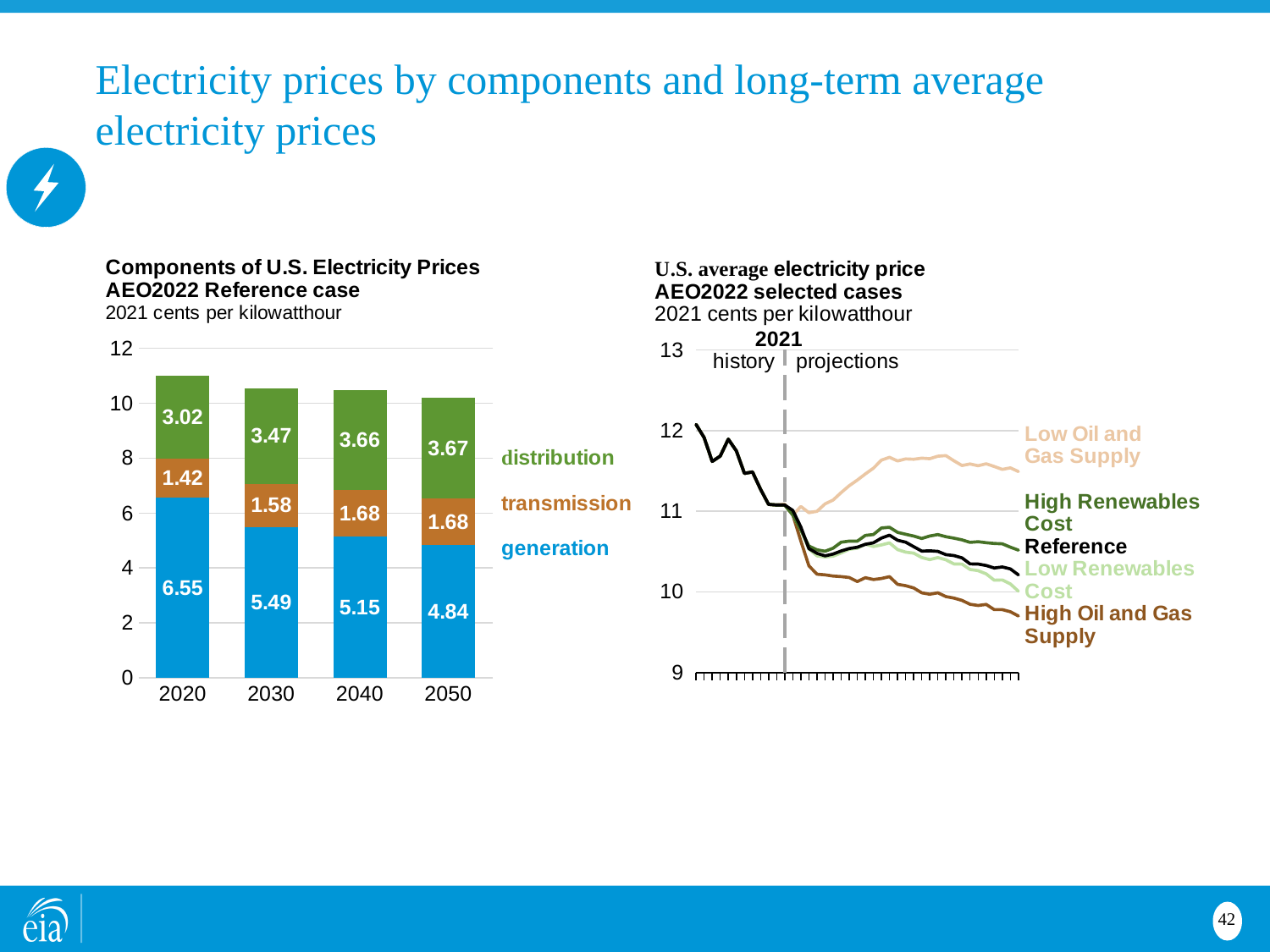
In the Components of U.S. Electricity Prices chart, what is the difference between the generation values for 2020 and 2050? 1.71 In the Components of U.S. Electricity Prices chart, which year has the highest generation value? 2020 In the Components of U.S. Electricity Prices chart, which year has the lowest distribution value? 2020 In the Components of U.S. Electricity Prices chart, does the generation component rise or fall from 2020 to 2050? fall In the U.S. average electricity price chart, is the value for the High Oil and Gas Supply case at the end of the projection greater or less than 10? less What kind of chart is the U.S. average electricity price chart on the right? line chart In the Components of U.S. Electricity Prices chart, what is the distribution value for 2050? 3.67 In the Components of U.S. Electricity Prices chart, what is the generation value for 2020? 6.55 In the Components of U.S. Electricity Prices chart, how many years are shown on the x axis? 4 In the U.S. average electricity price chart, how many cases (series) are labelled? 5 In the Components of U.S. Electricity Prices chart, what is the total of the stacked bar for 2030? 10.54 In the Components of U.S. Electricity Prices chart, what is the transmission value for 2030? 1.58